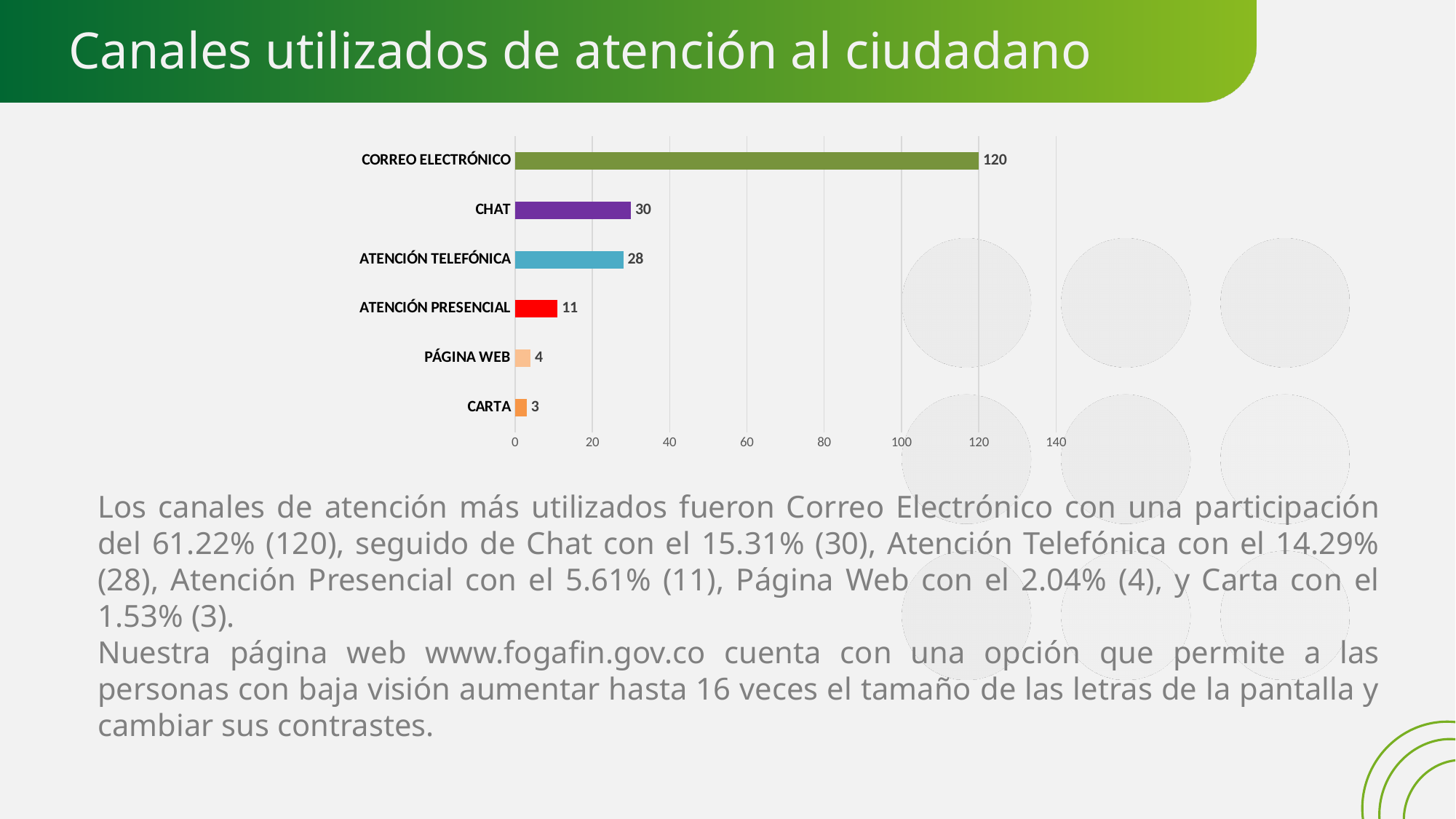
How many categories are shown in the chart? 6 Is the value for CORREO ELECTRÓNICO greater or less than 100? greater What is the value for ATENCIÓN TELEFÓNICA? 28 Which category has the highest value? CORREO ELECTRÓNICO What colour is the bar for ATENCIÓN PRESENCIAL? red What is the difference between the values for CORREO ELECTRÓNICO and CARTA? 117 What is the difference between the values for CHAT and ATENCIÓN PRESENCIAL? 19 Which category has the lowest value? CARTA What is the value for CORREO ELECTRÓNICO? 120 What kind of chart is shown on the slide? bar chart What is the value for PÁGINA WEB? 4 Which is larger, the value for CHAT or the value for ATENCIÓN TELEFÓNICA? CHAT